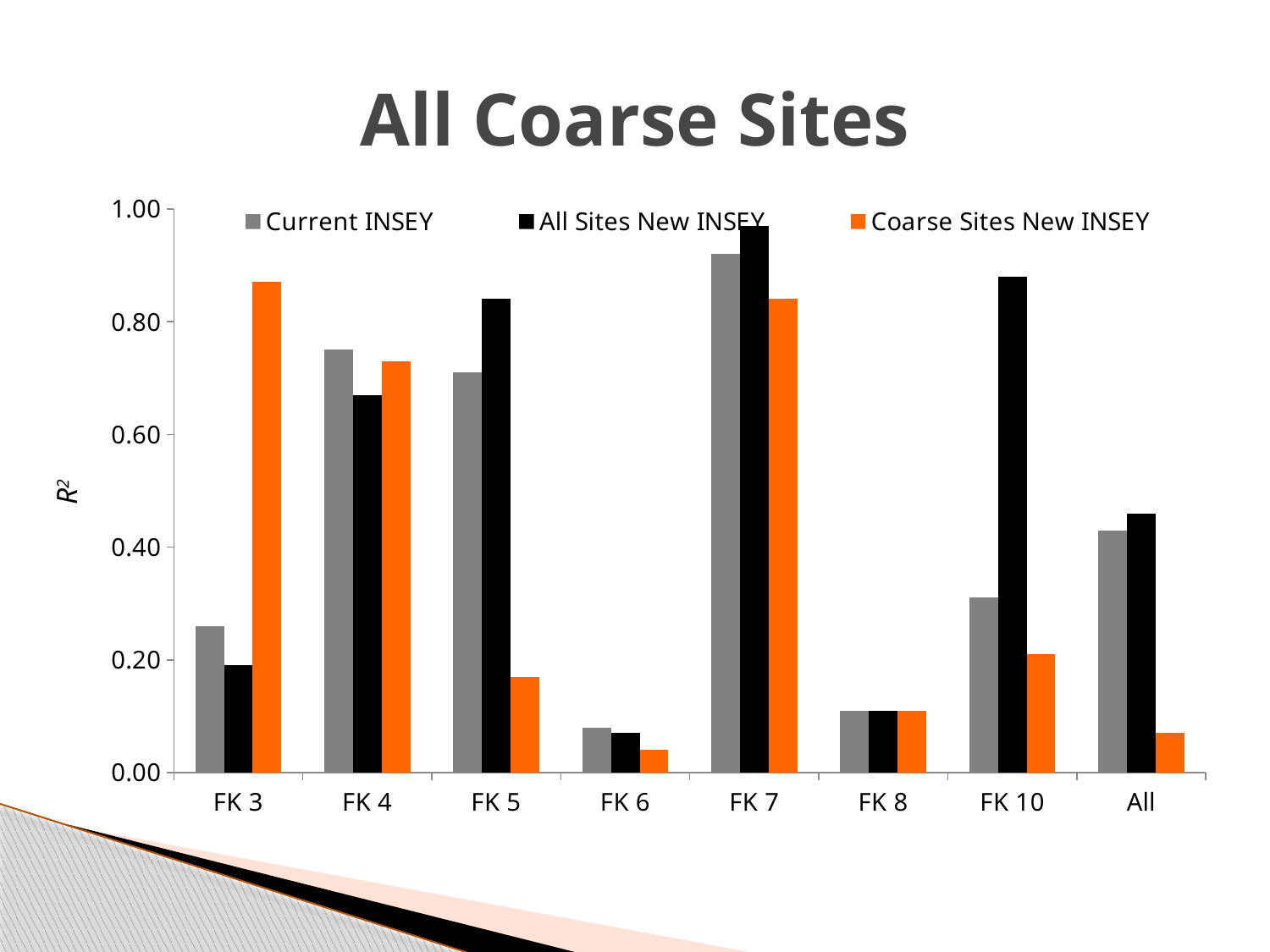
For FK 5, which is larger: Current INSEY or All Sites New INSEY? All Sites New INSEY Is the All Sites New INSEY value for FK 10 greater or less than 0.80? greater For FK 10, which is larger: Current INSEY or Coarse Sites New INSEY? Current INSEY Is the Coarse Sites New INSEY value for FK 5 greater or less than 0.20? less Is the Coarse Sites New INSEY value for FK 3 greater or less than 0.80? greater How many categories are shown on the x axis? 8 What kind of chart is shown on the slide? bar chart Which category has the highest value for Current INSEY? FK 7 How many series does the legend list? 3 What is the label on the y axis? R² Which category has the highest value for All Sites New INSEY? FK 7